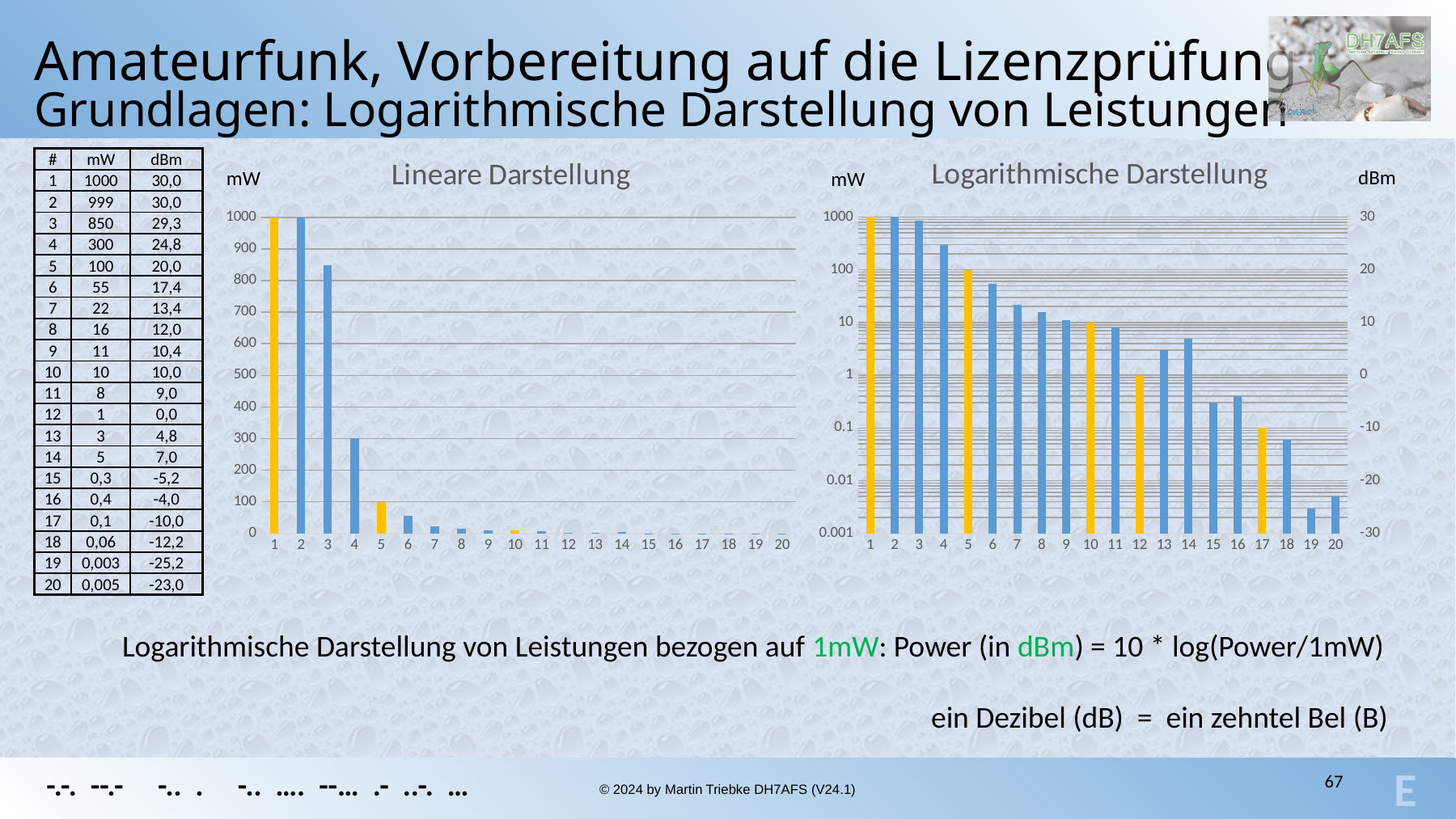
In the 'Logarithmische Darstellung' chart, which category has the lowest value? 19 In the 'Logarithmische Darstellung' chart, is the value for category 6 greater or less than 100? less In the 'Logarithmische Darstellung' chart, what is the value (in mW) for category 12? 1 In the 'Lineare Darstellung' chart, which is larger, the value for category 4 or category 5? category 4 What kind of chart is the 'Lineare Darstellung' chart? bar chart In the 'Lineare Darstellung' chart, is the value for category 4 greater or less than 400? less In the 'Lineare Darstellung' chart, is the value for category 3 greater or less than 800? greater How many categories are plotted on the x axis of the 'Logarithmische Darstellung' chart? 20 In the 'Logarithmische Darstellung' chart, do the values generally rise or fall from left to right along the x axis? fall In the 'Lineare Darstellung' chart, what is the value for category 1? 1000 In the 'Logarithmische Darstellung' chart, what is the value (in mW) for category 5? 100 What is the label on the right-hand axis of the 'Logarithmische Darstellung' chart? dBm